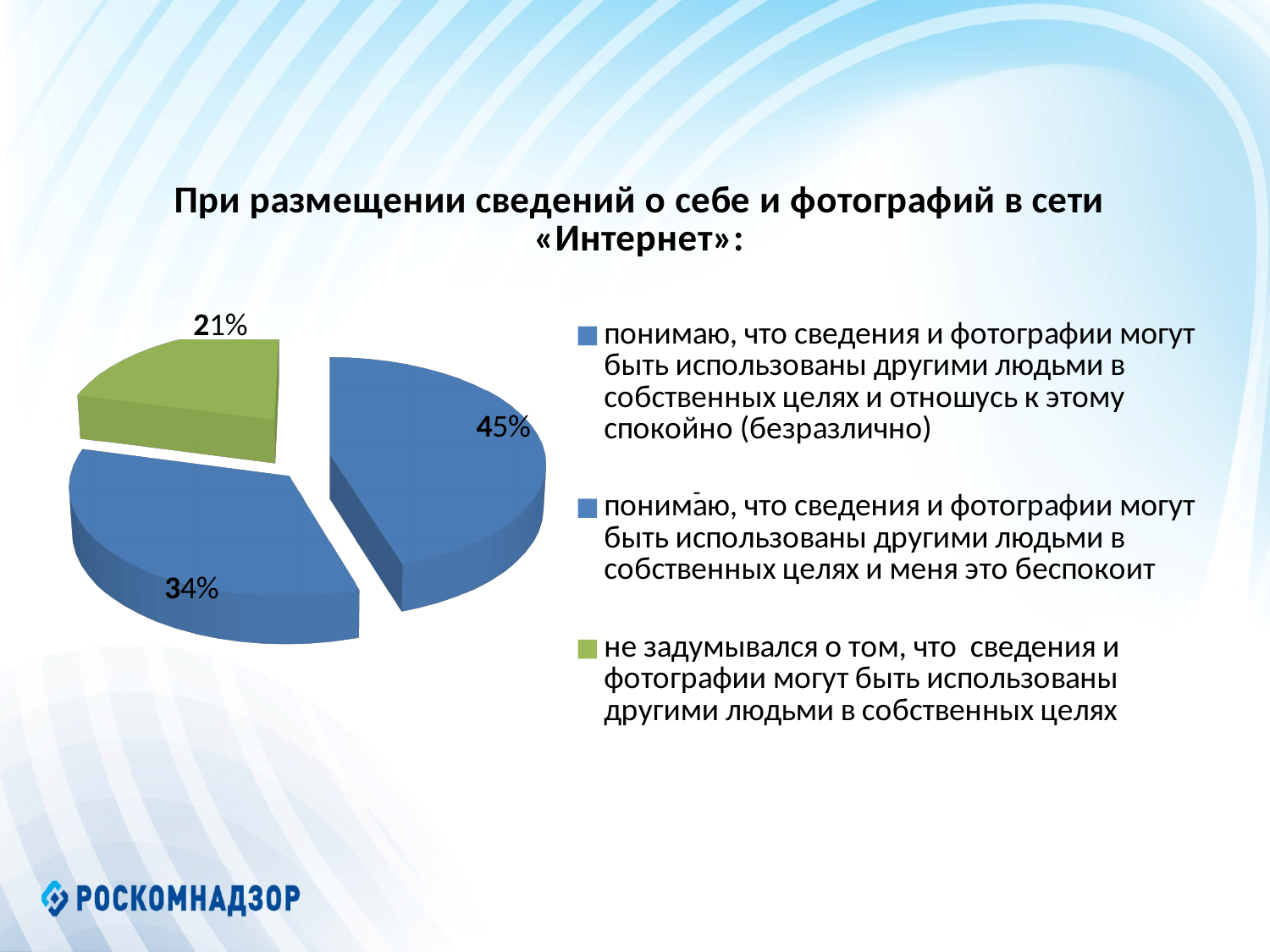
What kind of chart is shown on the slide? pie chart What is the difference between the 45% slice and the 34% slice? 11% What colour is the slice labelled 21%? green How many slices does the pie chart have? 3 What is the value of the smallest slice of the pie chart? 21% Which is larger: the 34% slice or the 21% slice? the 34% slice What percentage corresponds to the legend entry «не задумывался о том, что сведения и фотографии могут быть использованы другими людьми в собственных целях»? 21% How many entries does the legend of the pie chart list? 3 What share of the pie is the green slice? 21% What is the difference between the largest slice (45%) and the smallest slice (21%) of the pie chart? 24% What is the value of the largest slice of the pie chart? 45% What is the title of the chart on the slide? При размещении сведений о себе и фотографий в сети «Интернет»: